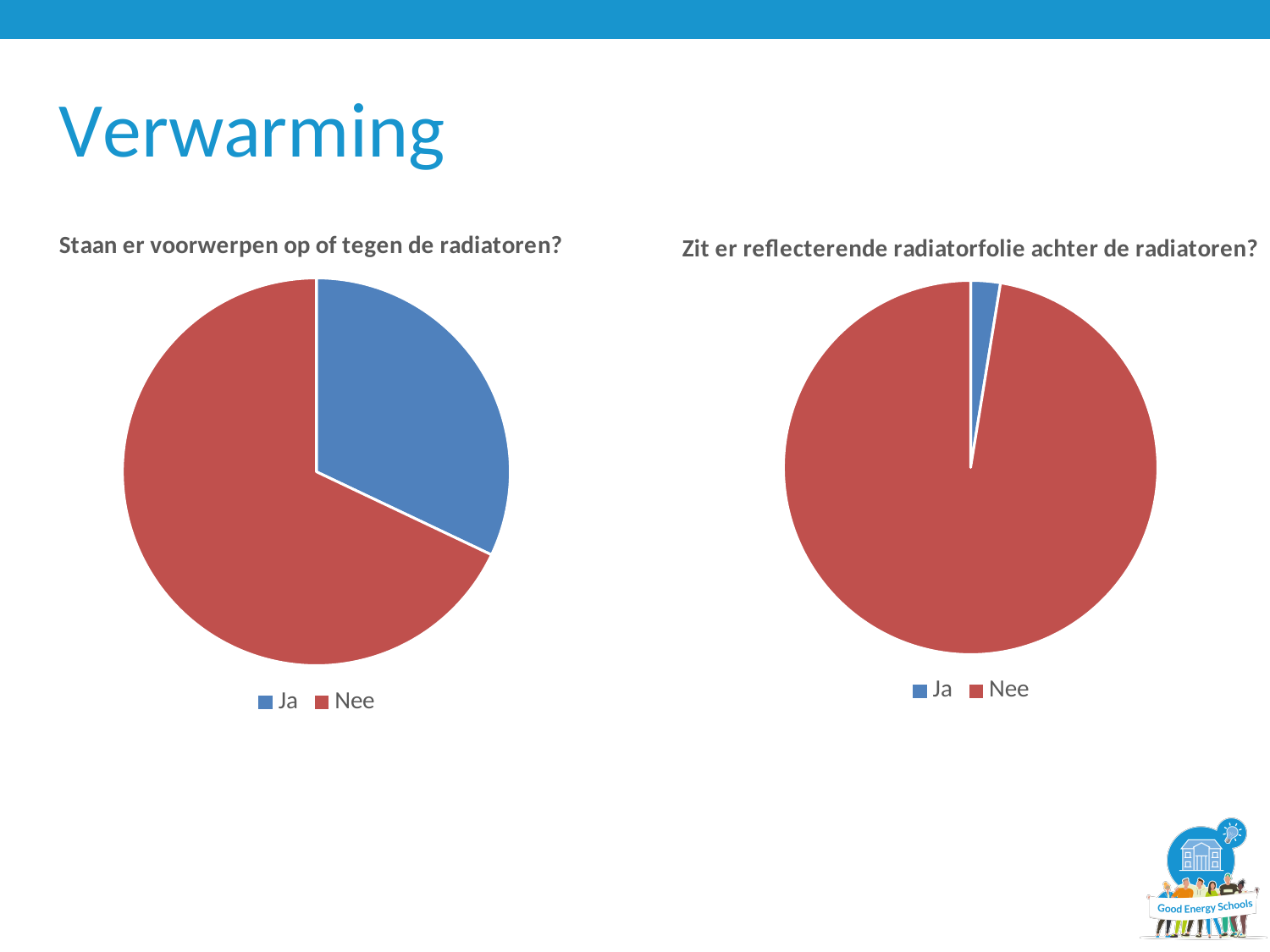
What is the title of the pie chart on the right side of the slide? Zit er reflecterende radiatorfolie achter de radiatoren? In the chart titled "Staan er voorwerpen op of tegen de radiatoren?", which category has the smallest slice? Ja In the chart titled "Zit er reflecterende radiatorfolie achter de radiatoren?", is the slice for Nee larger or smaller than the slice for Ja? Larger How many slices does the chart titled "Staan er voorwerpen op of tegen de radiatoren?" have? 2 What kind of chart is the chart titled "Staan er voorwerpen op of tegen de radiatoren?"? Pie chart In the chart titled "Zit er reflecterende radiatorfolie achter de radiatoren?", which category has the smallest slice? Ja In the chart titled "Staan er voorwerpen op of tegen de radiatoren?", is the slice for Ja larger or smaller than the slice for Nee? Smaller In the chart titled "Staan er voorwerpen op of tegen de radiatoren?", what colour is the slice for Ja? Blue How many entries does the legend of the chart titled "Zit er reflecterende radiatorfolie achter de radiatoren?" list? 2 In the chart titled "Zit er reflecterende radiatorfolie achter de radiatoren?", which category has the largest slice? Nee In the chart titled "Staan er voorwerpen op of tegen de radiatoren?", which category has the largest slice? Nee What kind of chart is the chart titled "Zit er reflecterende radiatorfolie achter de radiatoren?"? Pie chart